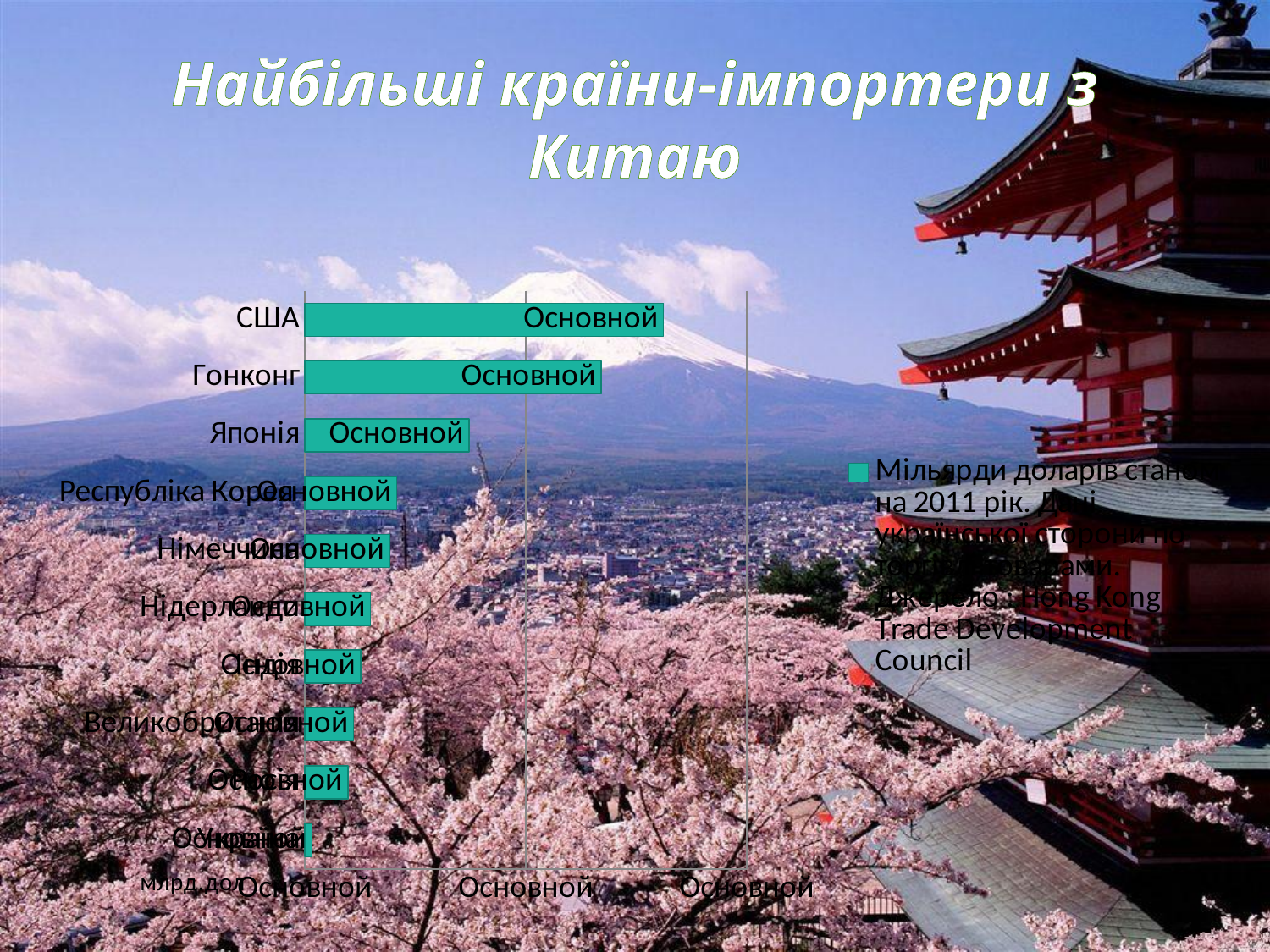
How many countries (bars) are shown in the chart? 10 What colour are the bars in the chart? teal (green) How many data series does the chart's legend list? 1 Do the bar lengths increase or decrease going from the top category (США) to the bottom category (Україна)? decrease Which has the larger value, Гонконг or Японія? Гонконг What kind of chart is shown on the slide? bar chart Which has the larger value, США or Гонконг? США Which country has the longest bar in the chart? США Which has the larger value, Японія or Республіка Корея? Японія Which country has the shortest bar in the chart? Україна What is the title of the slide's chart? млрд.дол